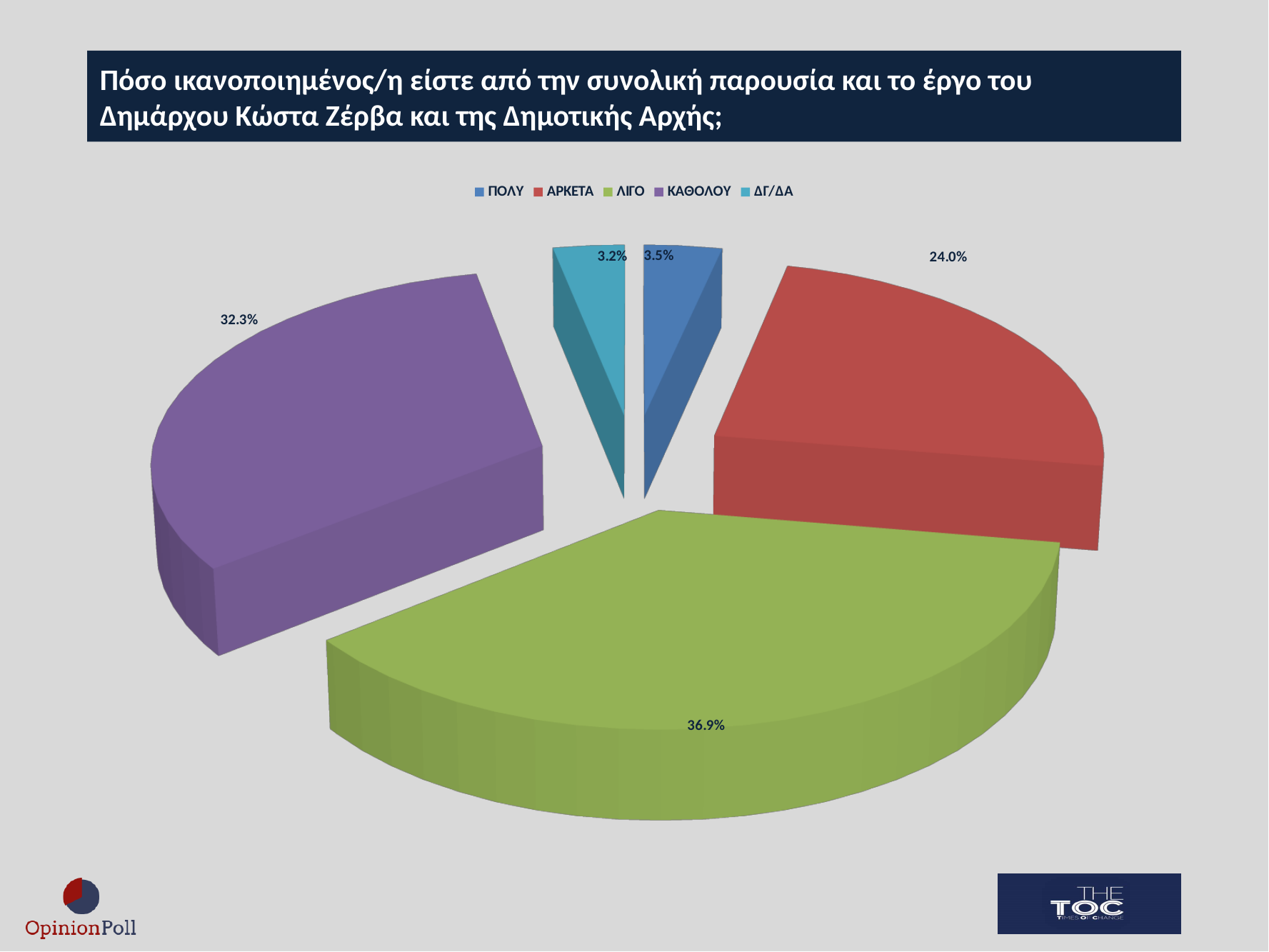
What percentage of respondents answered ΚΑΘΟΛΟΥ? 32.3% What percentage of respondents answered ΑΡΚΕΤΑ? 24.0% What percentage of respondents answered ΠΟΛΥ? 3.5% What is the difference in percentage points between ΛΙΓΟ and ΚΑΘΟΛΟΥ? 4.6 What percentage of respondents answered ΛΙΓΟ? 36.9% Which response category has the smallest share of the pie? ΔΓ/ΔΑ Which is larger, the share for ΑΡΚΕΤΑ or the share for ΚΑΘΟΛΟΥ? ΚΑΘΟΛΟΥ What percentage of respondents answered ΔΓ/ΔΑ? 3.2% Which response category has the largest share of the pie? ΛΙΓΟ What type of chart is shown on the slide? Pie chart What colour represents ΚΑΘΟΛΟΥ in the chart? Purple How many categories does the pie chart show? 5